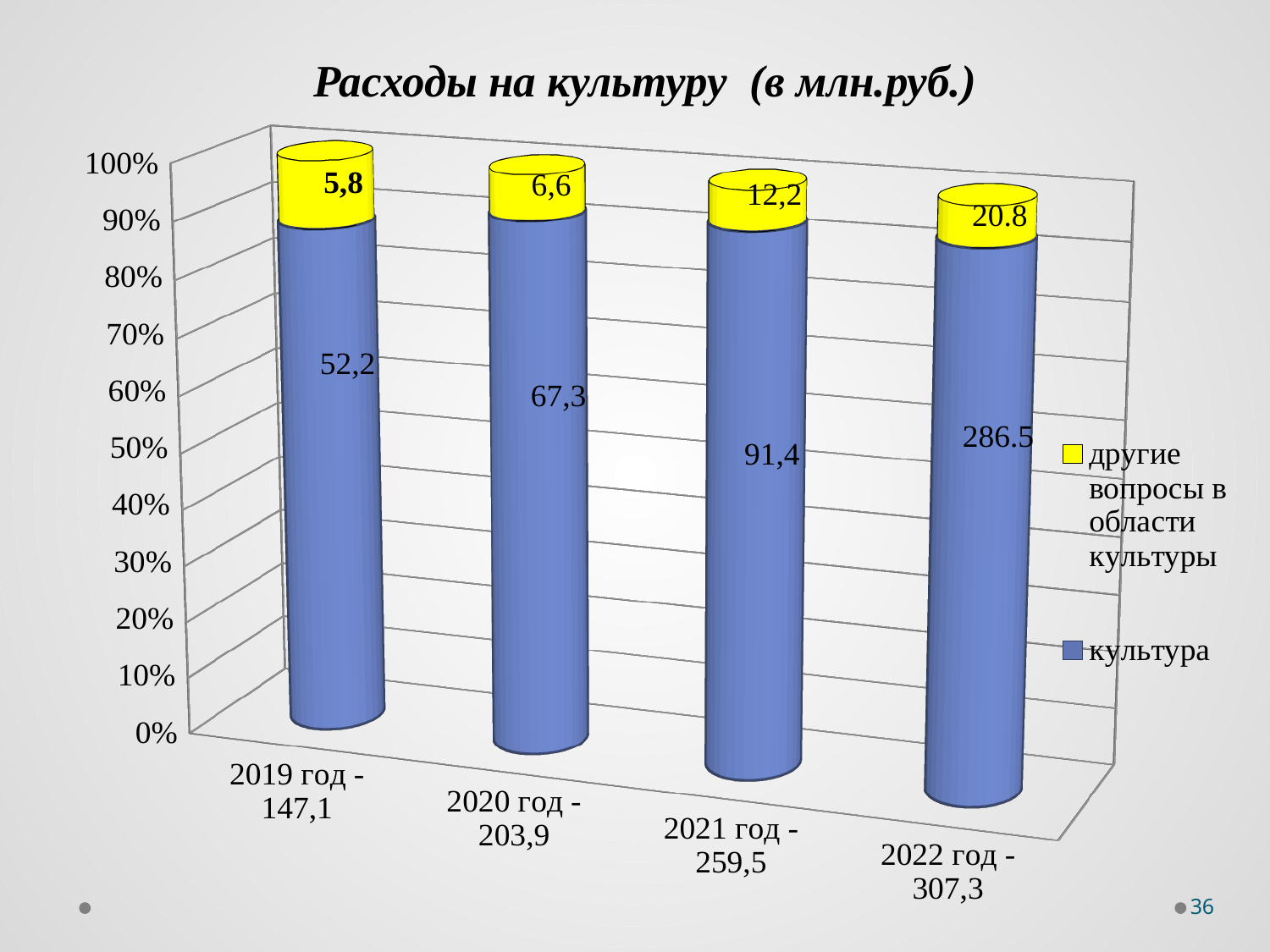
What is the value for другие вопросы в области культуры in 2020 год? 6,6 How many years are shown on the x axis? 4 In which year is the value for другие вопросы в области культуры the lowest? 2019 год In which year is the value for культура the highest? 2022 год What is the value for культура in 2019 год? 52,2 What is the difference between the культура values for 2021 год and 2020 год? 24,1 What is the value for другие вопросы в области культуры in 2022 год? 20.8 How many series does the legend list? 2 What kind of chart is shown on the slide? Stacked bar chart Which is larger: the другие вопросы в области культуры value for 2021 год or for 2020 год? 2021 год What is the title of the chart? Расходы на культуру (в млн.руб.) What is the value for культура in 2021 год? 91,4